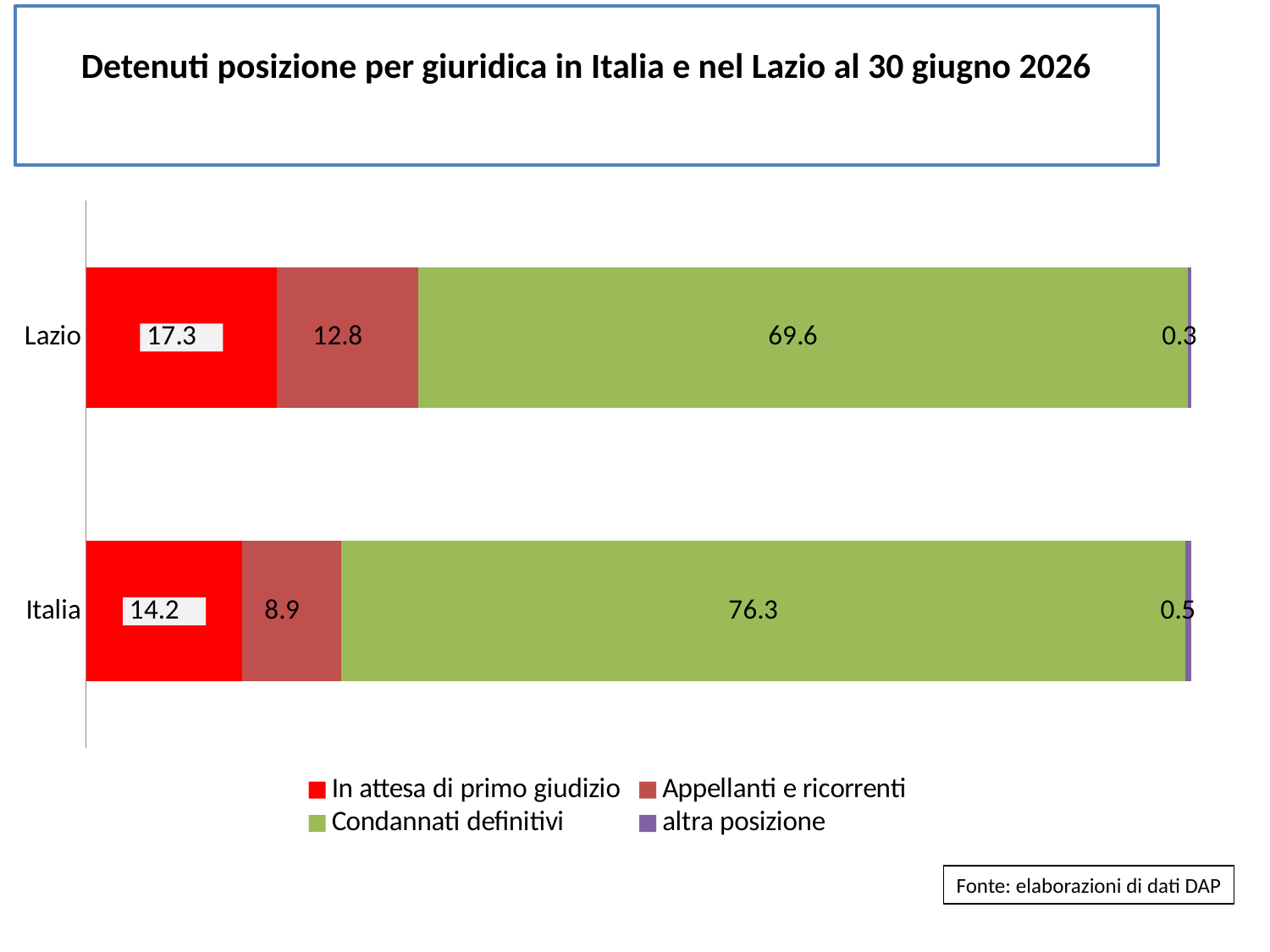
How many categories (bars) are shown in the chart? 2 What is the value for 'In attesa di primo giudizio' in Lazio? 17.3 What kind of chart is shown on the slide? Stacked bar chart How many series does the legend list? 4 What is the total of the Lazio stacked bar? 100 What is the value for 'altra posizione' in Italia? 0.5 Which series has the smallest value in the Lazio bar? altra posizione What is the value for 'Appellanti e ricorrenti' in Lazio? 12.8 What is the value for 'Condannati definitivi' in Italia? 76.3 Which series has the largest value in the Italia bar? Condannati definitivi Which has a larger value for 'In attesa di primo giudizio', Lazio or Italia? Lazio What is the difference between the 'Condannati definitivi' values for Italia and Lazio? 6.7